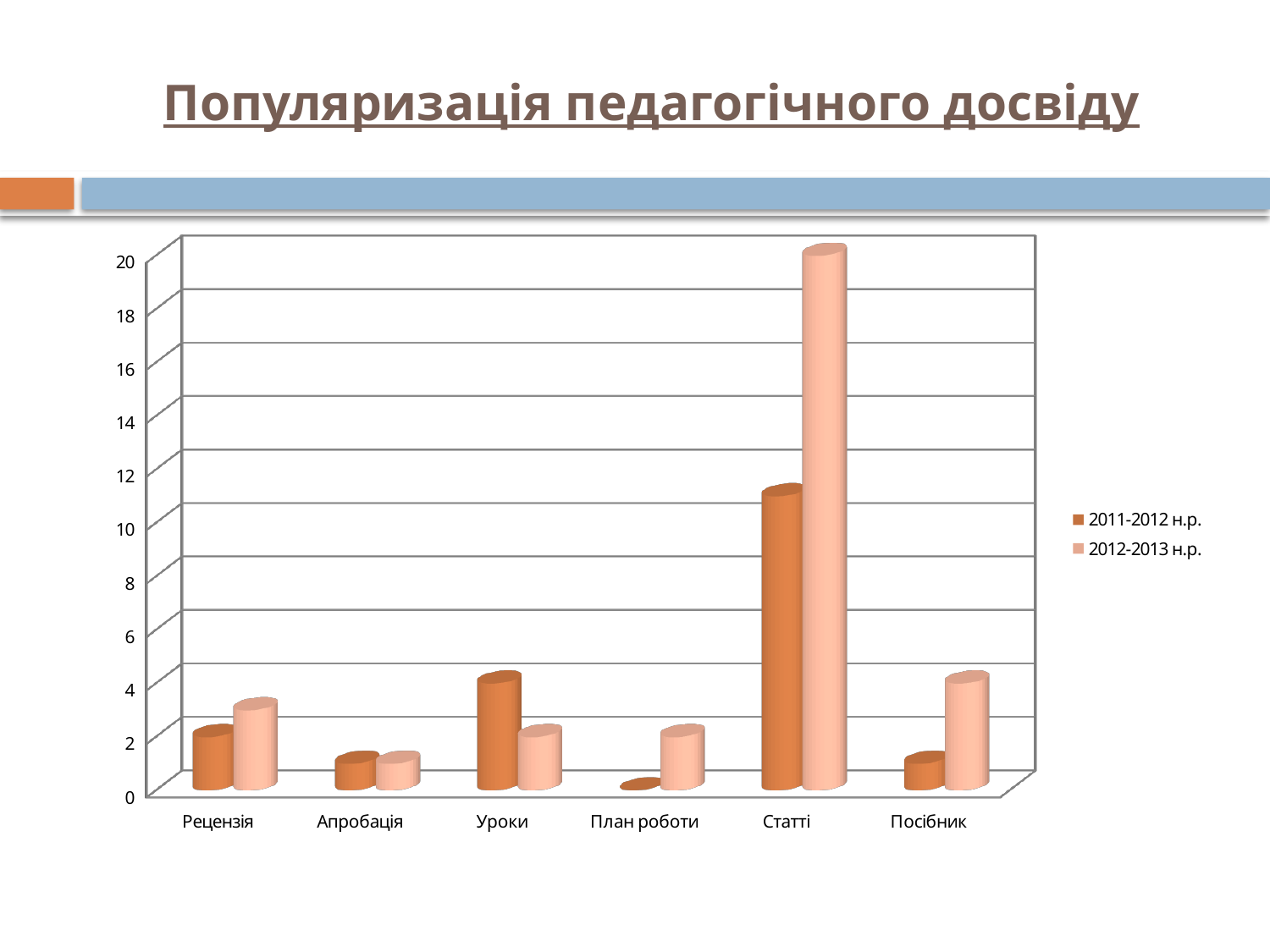
Which category has the highest value for the 2011-2012 н.р. series? Статті What is the title of the slide containing the chart? Популяризація педагогічного досвіду How many series does the chart legend list? 2 Is the value for Статті in the 2011-2012 н.р. series greater or less than 10? greater What kind of chart is shown on the slide? bar chart Is the value for Статті in the 2012-2013 н.р. series greater or less than 18? greater How many categories are shown on the x axis of the chart? 6 Which category has the highest value for the 2012-2013 н.р. series? Статті For Уроки, which series has the larger value, 2011-2012 н.р. or 2012-2013 н.р.? 2011-2012 н.р. Which category has the lowest value for the 2011-2012 н.р. series? План роботи Is the value for Уроки in the 2011-2012 н.р. series greater or less than 6? less For Посібник, which series has the larger value, 2011-2012 н.р. or 2012-2013 н.р.? 2012-2013 н.р.